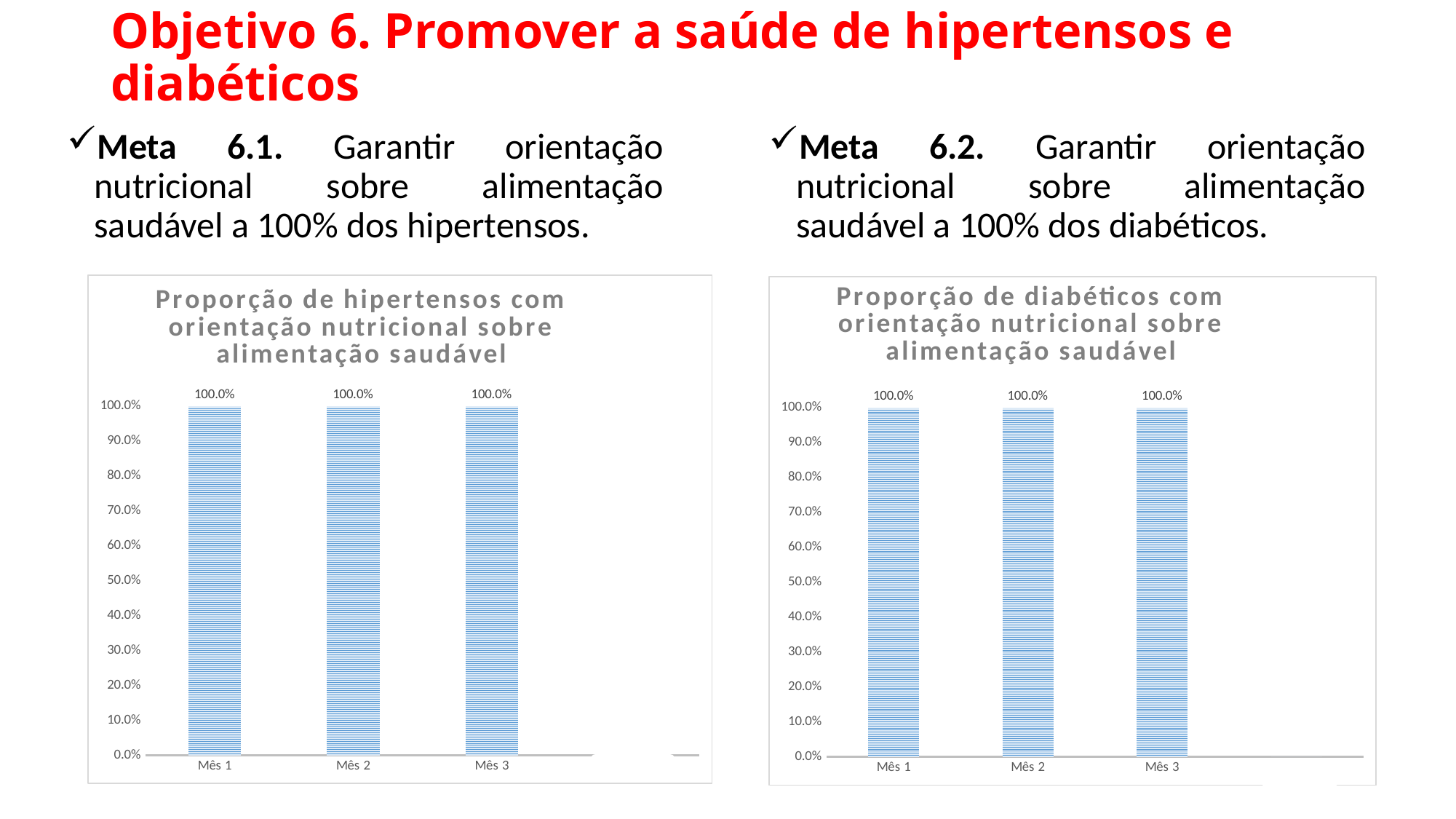
In the right chart (Proporção de diabéticos com orientação nutricional sobre alimentação saudável), what is the difference between the values for Mês 3 and Mês 1? 0.0% In the left chart (Proporção de hipertensos com orientação nutricional sobre alimentação saudável), what is the value for Mês 3? 100.0% In the left chart (Proporção de hipertensos com orientação nutricional sobre alimentação saudável), do the values rise, fall or stay the same from Mês 1 to Mês 3? stay the same In the right chart (Proporção de diabéticos com orientação nutricional sobre alimentação saudável), what is the value for Mês 3? 100.0% In the right chart (Proporção de diabéticos com orientação nutricional sobre alimentação saudável), what is the value for Mês 2? 100.0% How many categories are shown on the x axis of the right chart (Proporção de diabéticos com orientação nutricional sobre alimentação saudável)? 3 What kind of chart is the right chart (Proporção de diabéticos com orientação nutricional sobre alimentação saudável)? bar chart How many categories are shown on the x axis of the left chart (Proporção de hipertensos com orientação nutricional sobre alimentação saudável)? 3 In the right chart (Proporção de diabéticos com orientação nutricional sobre alimentação saudável), is the value for Mês 1 greater or less than 90.0%? greater In the left chart (Proporção de hipertensos com orientação nutricional sobre alimentação saudável), what is the difference between the values for Mês 1 and Mês 2? 0.0% In the left chart (Proporção de hipertensos com orientação nutricional sobre alimentação saudável), is the value for Mês 2 greater or less than 50.0%? greater In the left chart (Proporção de hipertensos com orientação nutricional sobre alimentação saudável), what is the value for Mês 1? 100.0%